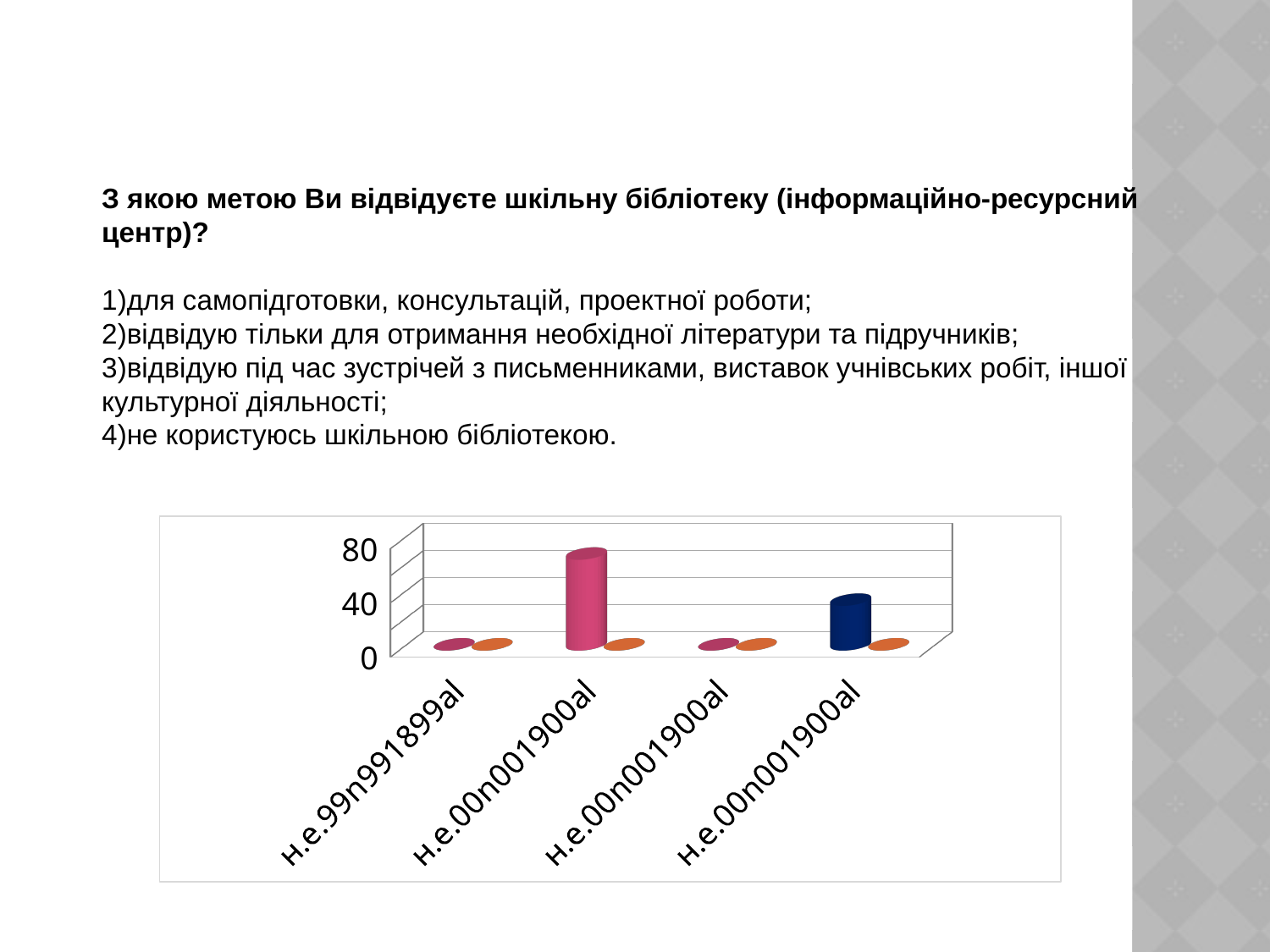
What colour is the tallest bar in the chart? pink Which bar is the tallest in the chart? the second bar What is the highest value labelled on the vertical axis of the chart? 80 Which is larger, the second bar or the fourth bar? the second bar How many categories are shown along the x axis of the chart? 4 Is the value of the fourth bar greater or less than 80? less What kind of chart is shown on the slide? bar chart Is the value of the second bar greater or less than 40? greater